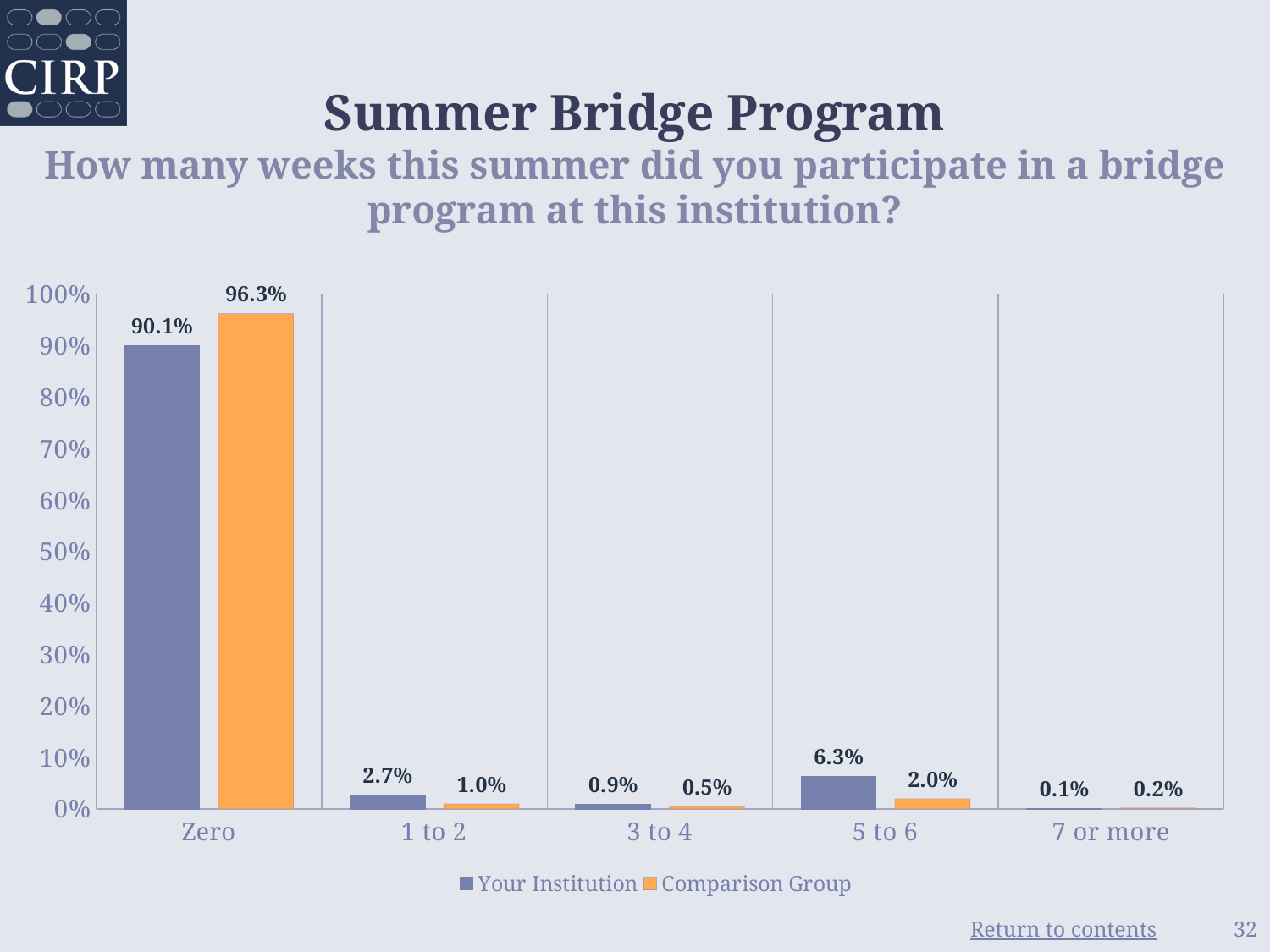
Which category has the lowest value for Your Institution? 7 or more What type of chart is shown on the slide? Bar chart How many series does the legend list? 2 What percentage of Your Institution respondents participated for Zero weeks? 90.1% What is the Your Institution value for 1 to 2 weeks? 2.7% For 3 to 4 weeks, which series has the larger value, Your Institution or Comparison Group? Your Institution What is the Comparison Group value for the 5 to 6 weeks category? 2.0% What is the difference between Your Institution and the Comparison Group for 5 to 6 weeks? 4.3% Which category has the highest value for the Comparison Group? Zero How many categories are shown on the x axis? 5 What is the difference between the Comparison Group and Your Institution values for Zero weeks? 6.2% Is the Your Institution value for Zero weeks greater or less than 80%? greater